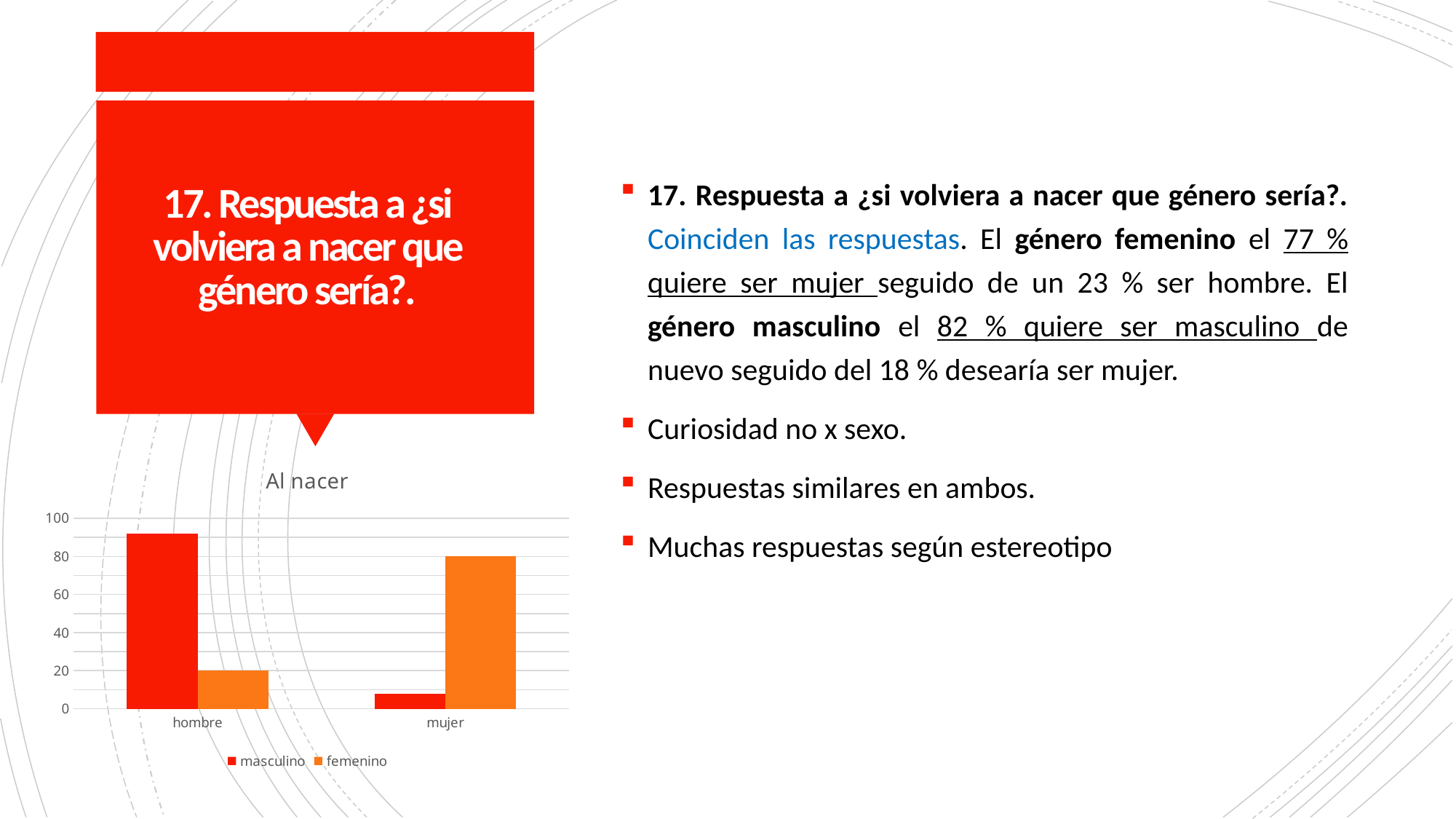
Is the value for masculino in the mujer category greater or less than 20? less Which series is shown in orange in the chart? femenino For the category mujer, which series has the taller bar, masculino or femenino? femenino Is the value for masculino in the hombre category greater or less than 80? greater Which category has the lowest value for the femenino series? hombre Does the masculino series rise or fall from hombre to mujer? fall What is the title of the chart? Al nacer How many series does the chart legend list? 2 For the category hombre, which series has the taller bar, masculino or femenino? masculino How many categories are shown on the x axis of the chart? 2 What kind of chart is shown on the slide? bar chart Which category has the highest value for the masculino series? hombre